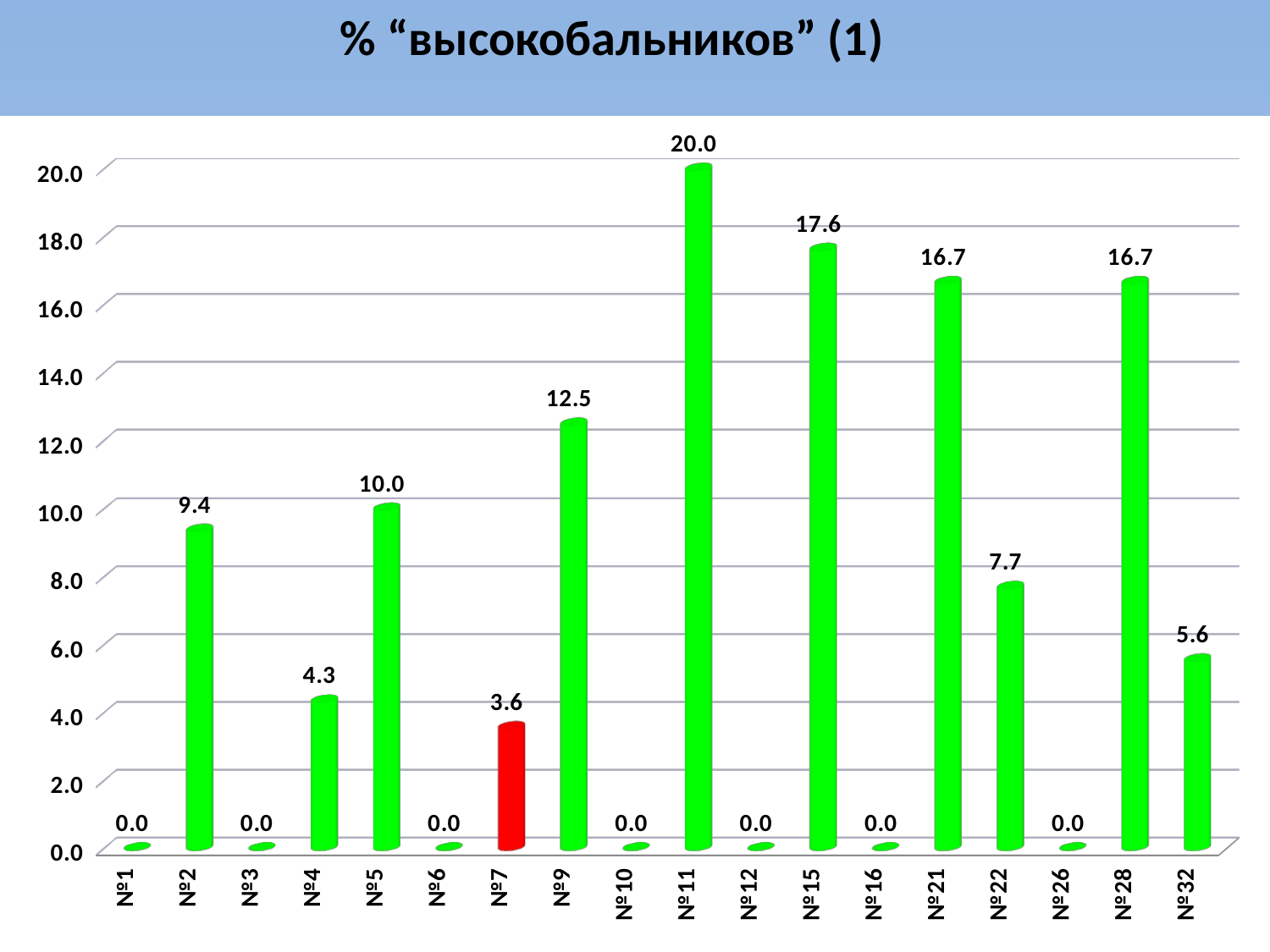
What is the value for №7? 3.6 How many categories have a value of 0.0? 7 What is the difference between the values for №9 and №4? 8.2 Which category has the highest value? №11 What is the value for №15? 17.6 What is the difference between the values for №11 and №15? 2.4 What is the value for №22? 7.7 What is the value for №11? 20.0 What kind of chart is this? bar chart How many categories are shown on the x axis? 18 Which is larger, the value for №5 or the value for №2? №5 Which category's bar is coloured red instead of green? №7